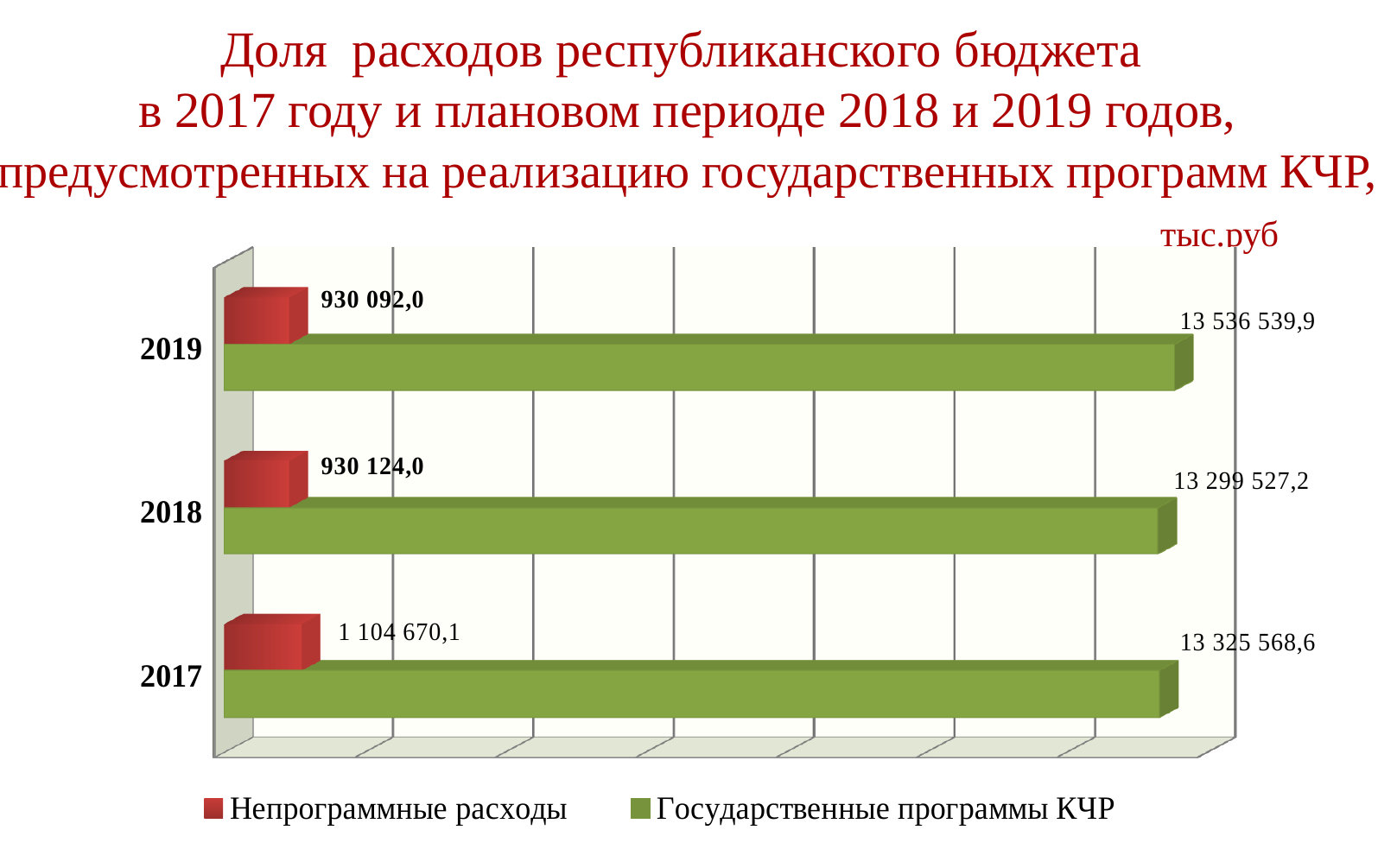
What kind of chart is shown on the slide? Bar chart How many years are shown on the chart? 3 In which year is the value of Непрограммные расходы the highest? 2017 How many series does the legend list? 2 What is the value of Непрограммные расходы for 2017? 1 104 670,1 What is the value of Государственные программы КЧР for 2018? 13 299 527,2 In which year is the value of Государственные программы КЧР the highest? 2019 Which is larger: Государственные программы КЧР in 2017 or in 2018? 2017 What is the value of Государственные программы КЧР for 2019? 13 536 539,9 In which year is the value of Государственные программы КЧР the lowest? 2018 What is the value of Непрограммные расходы for 2019? 930 092,0 What is the difference between the Государственные программы КЧР values for 2019 and 2018? 237 012,7